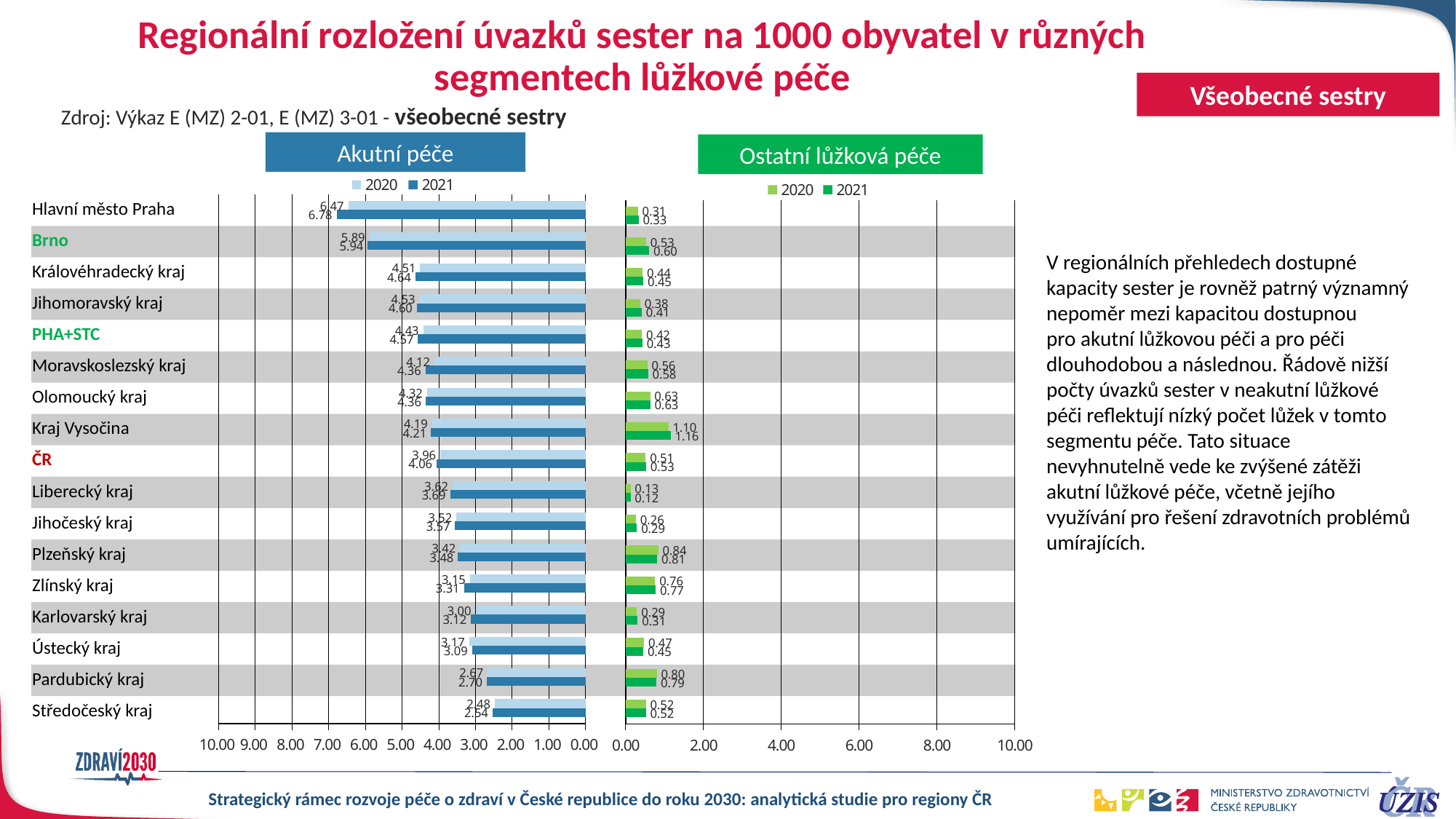
How many regions (categories) are listed in the 'Akutní péče' chart? 17 What type of chart is the 'Akutní péče' chart? Bar chart In the 'Akutní péče' chart, what is the 2021 value for Hlavní město Praha? 6.78 In the 'Ostatní lůžková péče' chart, which region has the lowest 2020 value? Liberecký kraj In the 'Akutní péče' chart, what is the difference between the 2021 and 2020 values for Moravskoslezský kraj? 0.24 In the 'Ostatní lůžková péče' chart, what is the 2021 value for Kraj Vysočina? 1.16 In the 'Akutní péče' chart, which region has the lowest 2021 value? Středočeský kraj In the 'Akutní péče' chart, what is the 2020 value for Středočeský kraj? 2.48 In the 'Ostatní lůžková péče' chart, what is the difference between the 2020 values for Plzeňský kraj and Jihočeský kraj? 0.58 In the 'Ostatní lůžková péče' chart, which region has the highest 2021 value? Kraj Vysočina How many series does the legend of the 'Ostatní lůžková péče' chart list? 2 In the 'Akutní péče' chart, which is larger for Ústecký kraj: the 2020 value or the 2021 value? 2020